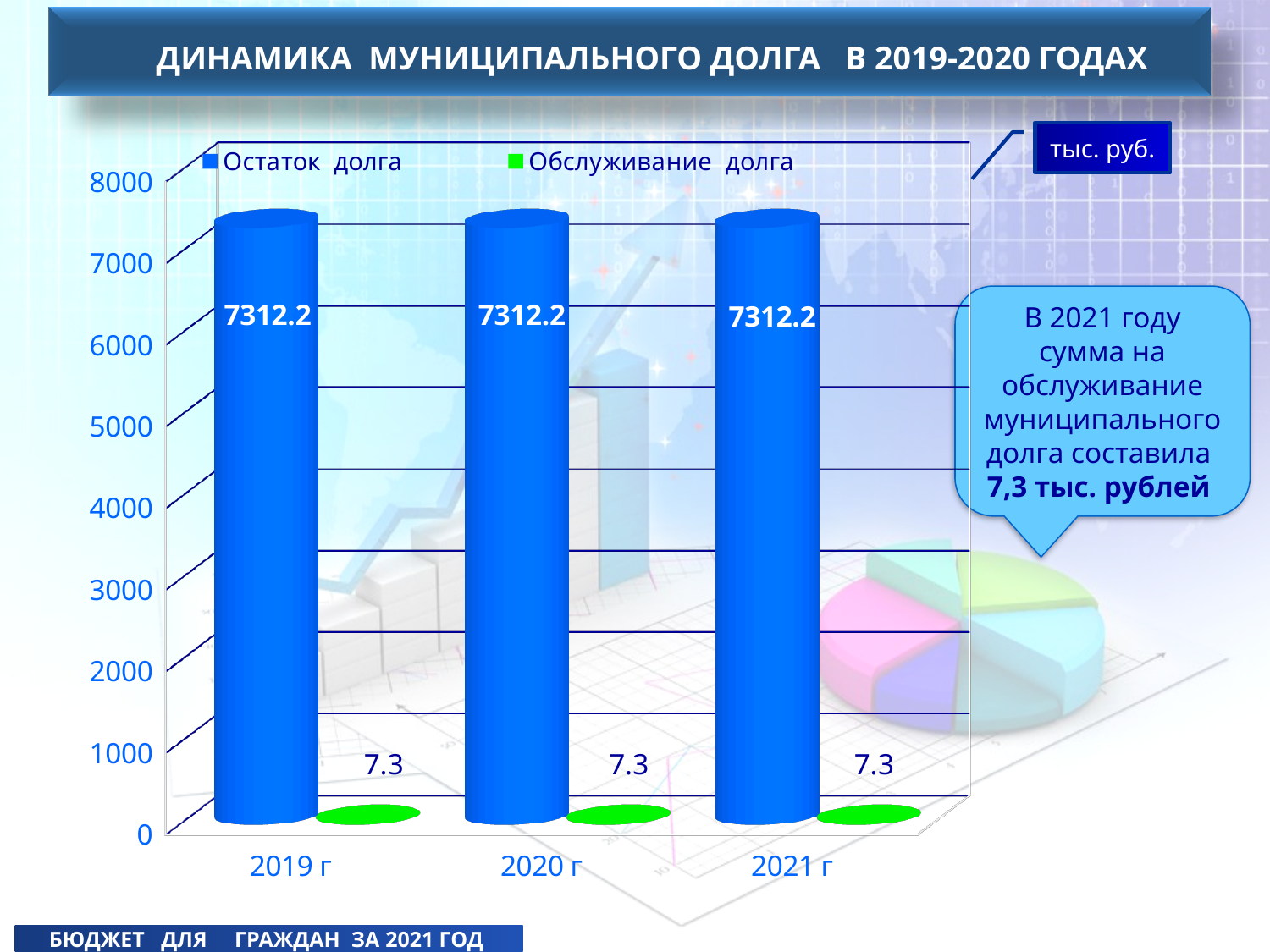
What is the value of Обслуживание долга for 2021 г? 7.3 How many series does the legend list? 2 Is the value of Остаток долга for 2020 г greater or less than 7000? greater What is the difference between Остаток долга and Обслуживание долга for 2020 г? 7304.9 What is the value of Остаток долга for 2021 г? 7312.2 Does the value of Остаток долга rise, fall or stay the same from 2019 г to 2021 г? stays the same What unit is indicated for the chart values? тыс. руб. What is the value of Обслуживание долга for 2020 г? 7.3 What kind of chart is shown on the slide? bar chart How many years (categories) are shown on the x axis? 3 What is the value of Остаток долга for 2019 г? 7312.2 Which is larger for 2019 г: Остаток долга or Обслуживание долга? Остаток долга